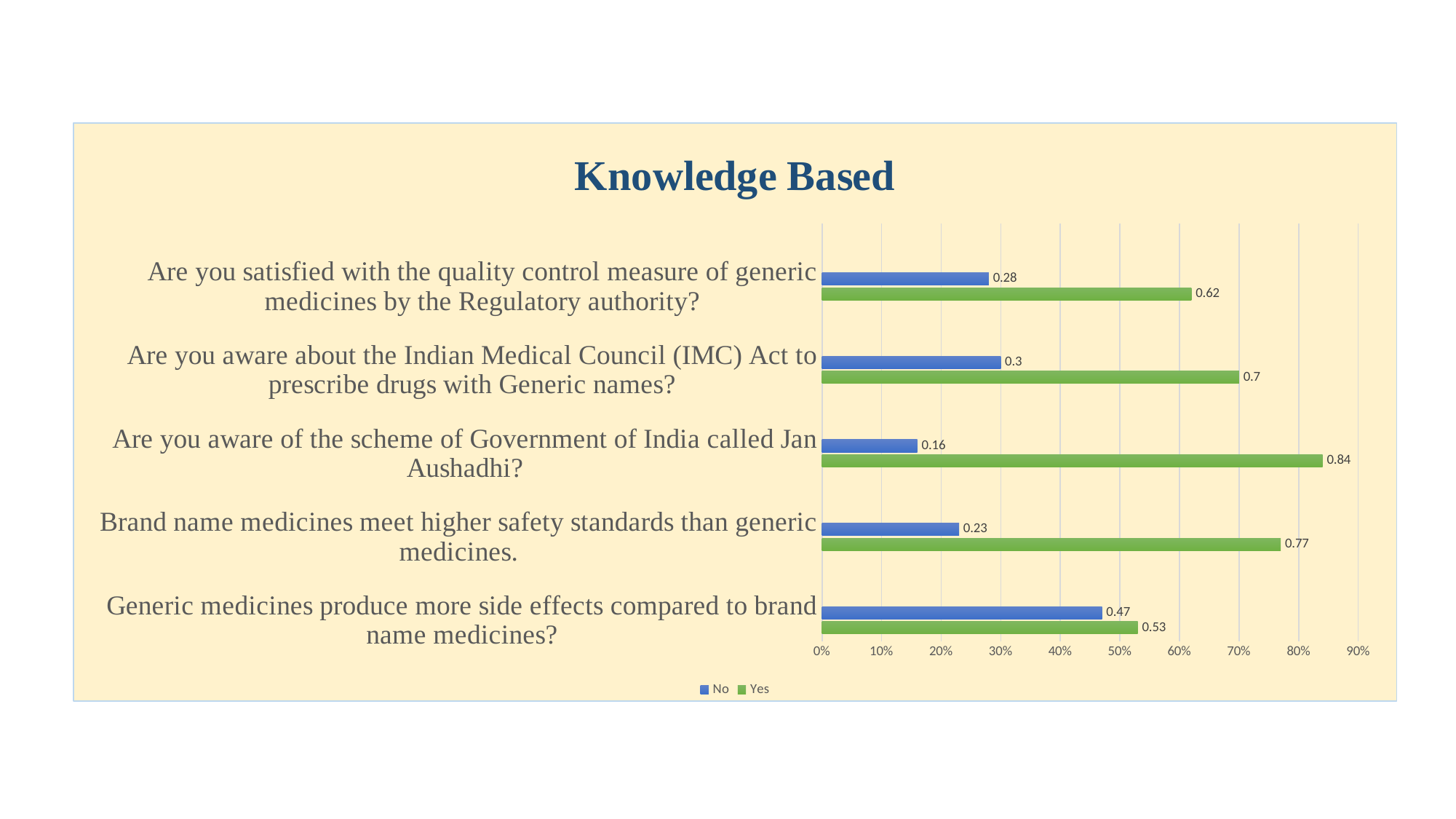
How many series does the legend list? 2 How many questions (categories) are shown on the chart? 5 Which question has the lowest 'No' value? Are you aware of the scheme of Government of India called Jan Aushadhi? What is the difference between the 'Yes' and 'No' values for 'Brand name medicines meet higher safety standards than generic medicines.'? 0.54 Which question has the highest 'Yes' value? Are you aware of the scheme of Government of India called Jan Aushadhi? What is the 'Yes' value for 'Are you satisfied with the quality control measure of generic medicines by the Regulatory authority?' 0.62 What is the 'Yes' value for 'Are you aware of the scheme of Government of India called Jan Aushadhi?' 0.84 Which is larger for 'Generic medicines produce more side effects compared to brand name medicines?': the 'Yes' value or the 'No' value? Yes What is the 'No' value for 'Generic medicines produce more side effects compared to brand name medicines?' 0.47 What is the title of the chart? Knowledge Based What kind of chart is shown on the slide? Bar chart What is the 'No' value for 'Are you aware about the Indian Medical Council (IMC) Act to prescribe drugs with Generic names?' 0.3